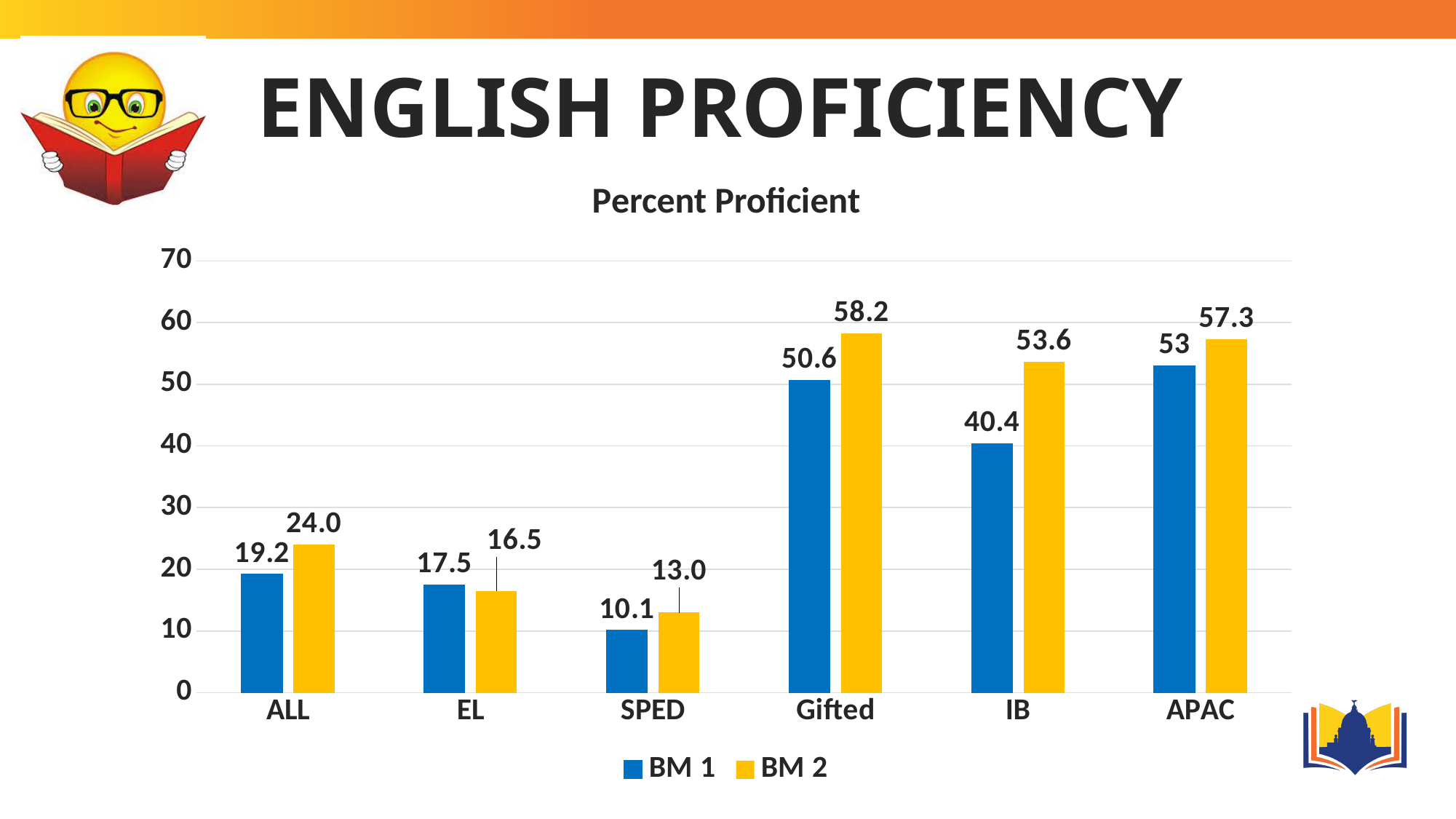
What is the difference between the BM 1 values for APAC and Gifted? 2.4 What is the difference between the BM 2 and BM 1 values for IB? 13.2 What is the BM 1 value for SPED? 10.1 How many categories are shown on the x axis? 6 What is the BM 2 value for Gifted? 58.2 Is the BM 2 value for ALL greater or less than 20? greater How many series does the legend list? 2 What is the BM 1 value for IB? 40.4 Which category has the highest BM 2 value? Gifted Which category has the lowest BM 1 value? SPED What type of chart is shown? bar chart For EL, which is larger, BM 1 or BM 2? BM 1